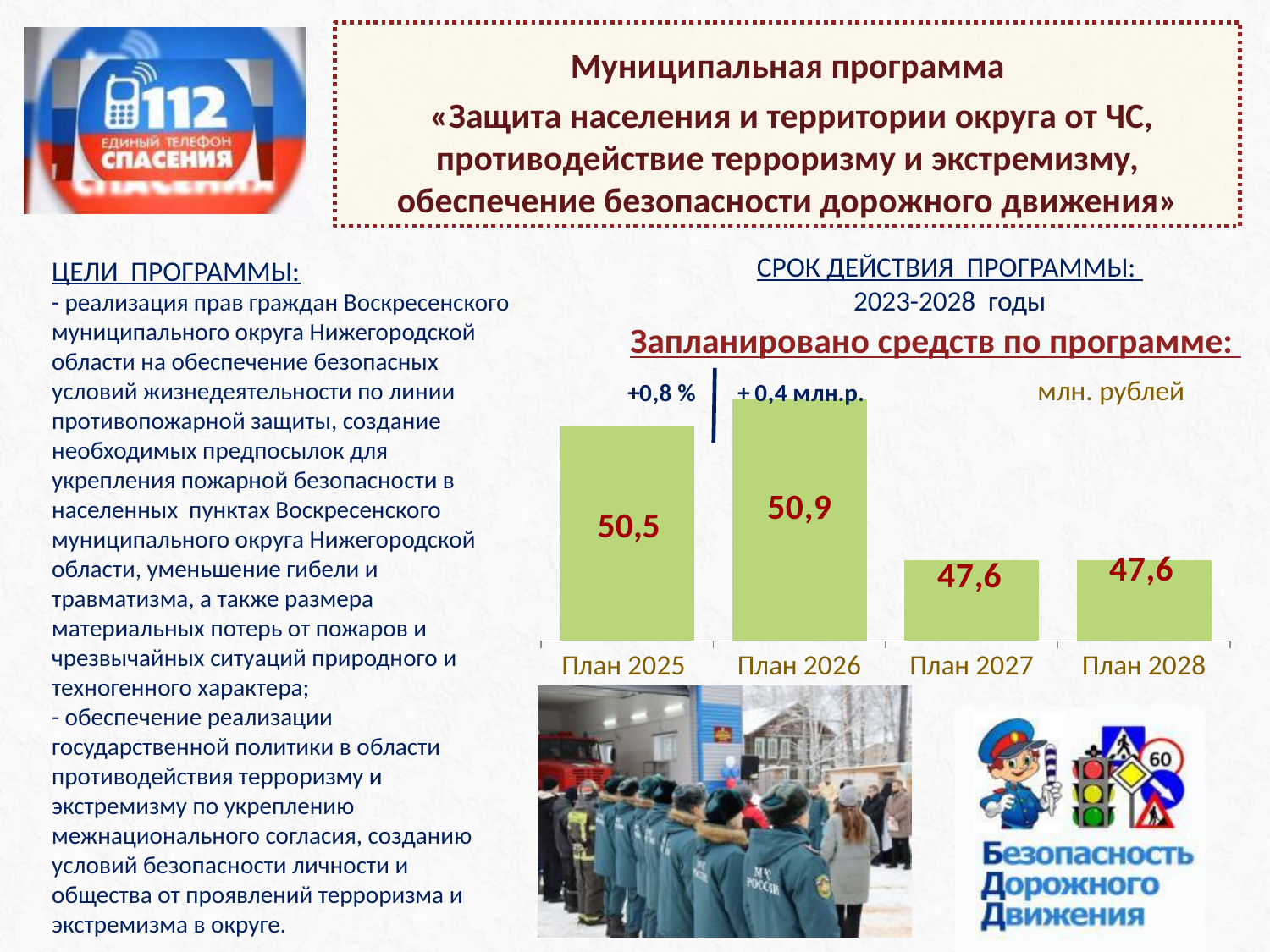
What unit is indicated for the chart values? млн. рублей How many categories are shown on the chart? 4 What kind of chart is shown on the slide? bar chart Which category has the highest value? План 2026 Which is larger, the value for План 2025 or the value for План 2027? План 2025 What value is shown for План 2027? 47,6 What value is shown for План 2025? 50,5 Do the values rise or fall from План 2026 to План 2027? fall What is the title of the chart? Запланировано средств по программе: What is the difference between the values for План 2026 and План 2028? 3,3 What value is shown for План 2026? 50,9 What is the difference between the values for План 2026 and План 2025? 0,4